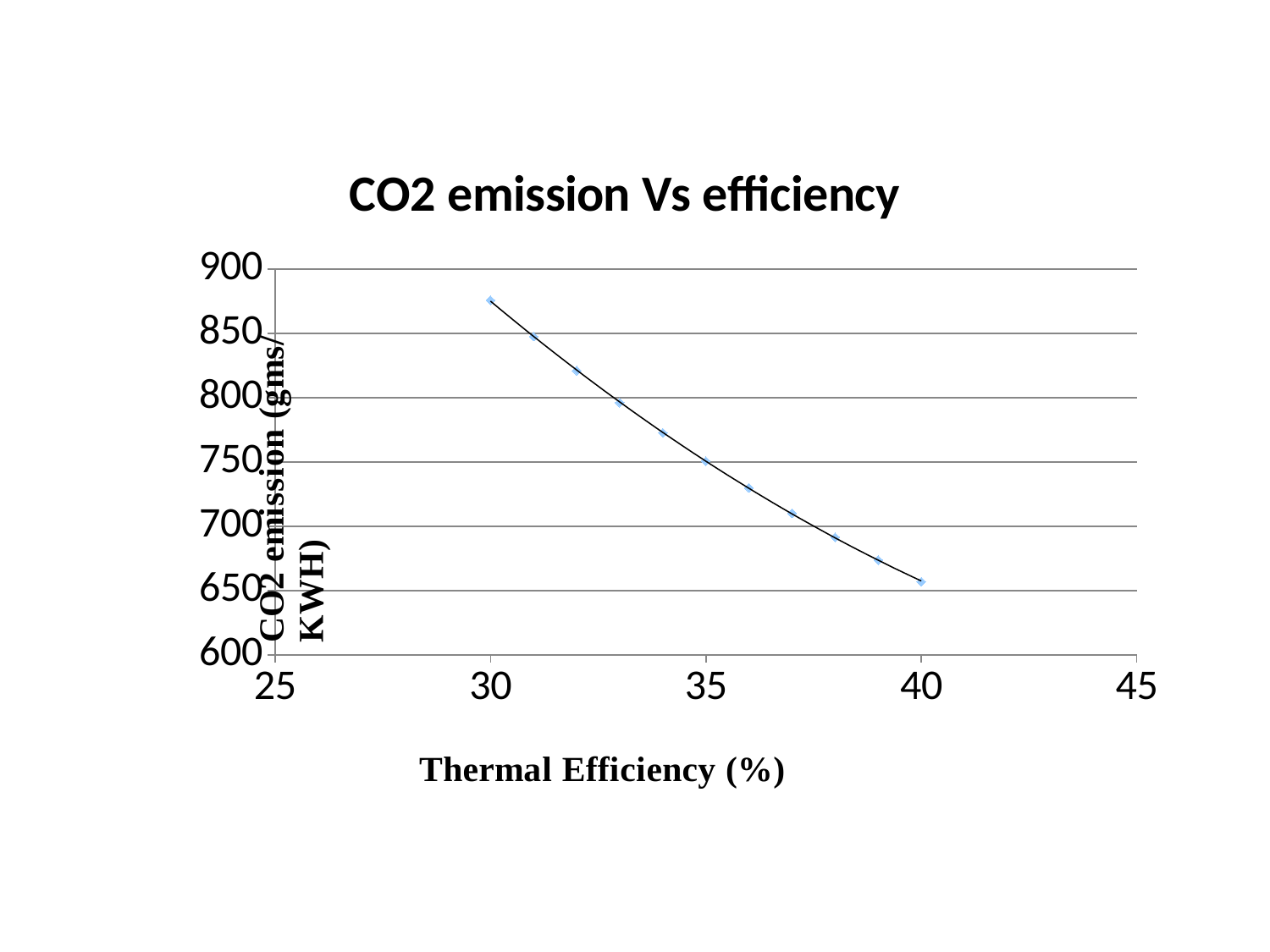
Is the CO2 emission value at 38% thermal efficiency greater or less than 700? less At which thermal efficiency value is CO2 emission highest? 30 Do CO2 emission values rise or fall as thermal efficiency increases along the x axis? fall Is the CO2 emission value at 34% thermal efficiency greater or less than 750? greater At which thermal efficiency value is CO2 emission lowest? 40 Is the CO2 emission value at 30% thermal efficiency greater or less than 850? greater How many data points are plotted on the chart? 11 What is the title of the chart? CO2 emission Vs efficiency What is the label of the x axis? Thermal Efficiency (%) Which has the larger CO2 emission value: 31% or 39% thermal efficiency? 31%